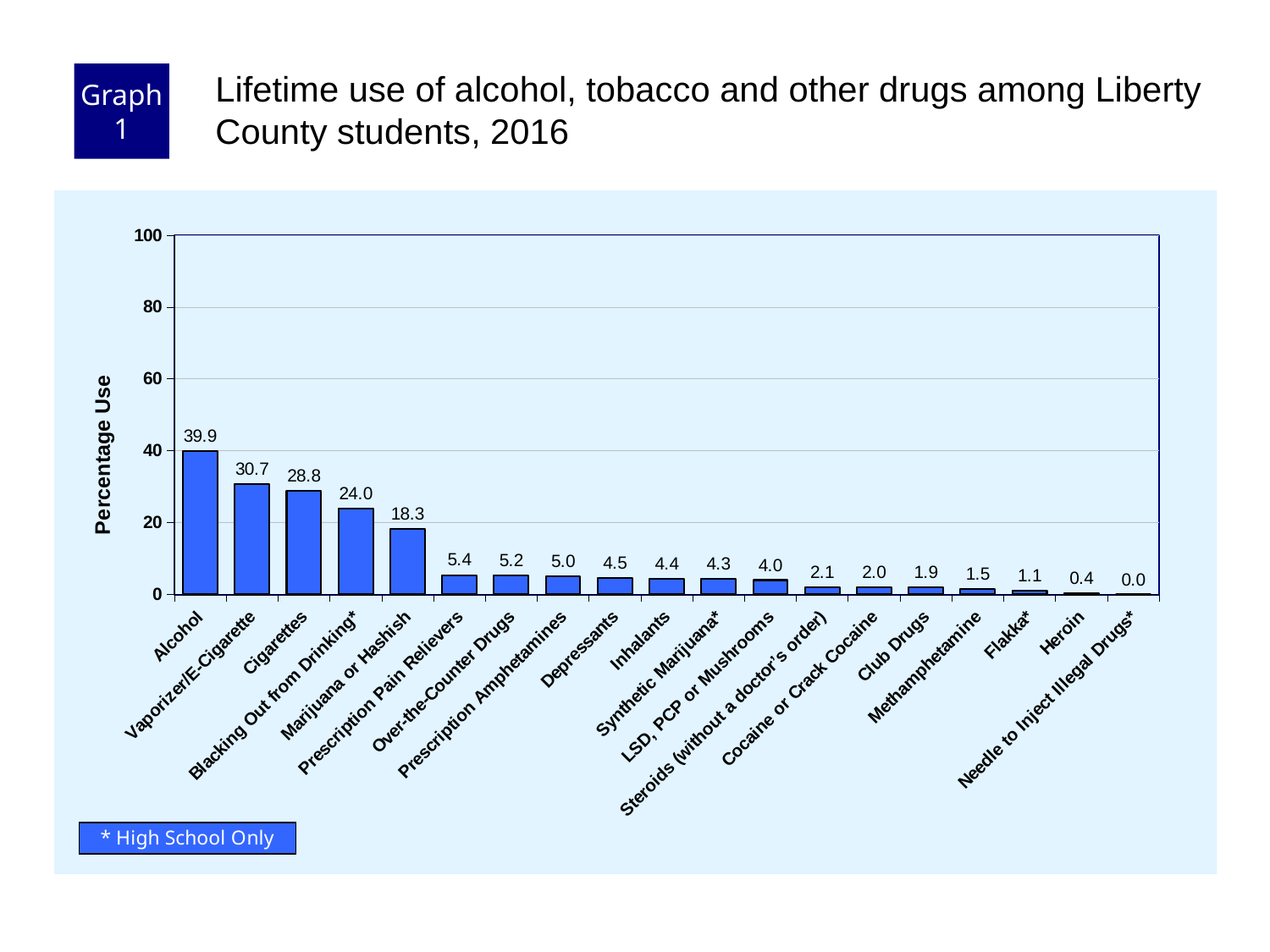
Is the value for Alcohol greater or less than 40? less How many categories are shown on the x axis? 19 What is the value for Alcohol? 39.9 What is the label of the y axis? Percentage Use Which category has the highest value? Alcohol Which category has the lowest value? Needle to Inject Illegal Drugs* What is the difference between the values for Alcohol and Cigarettes? 11.1 What is the value for Synthetic Marijuana*? 4.3 What is the value for Marijuana or Hashish? 18.3 What kind of chart is shown? bar chart What is the value for Heroin? 0.4 Which is larger, the value for Vaporizer/E-Cigarette or the value for Blacking Out from Drinking*? Vaporizer/E-Cigarette